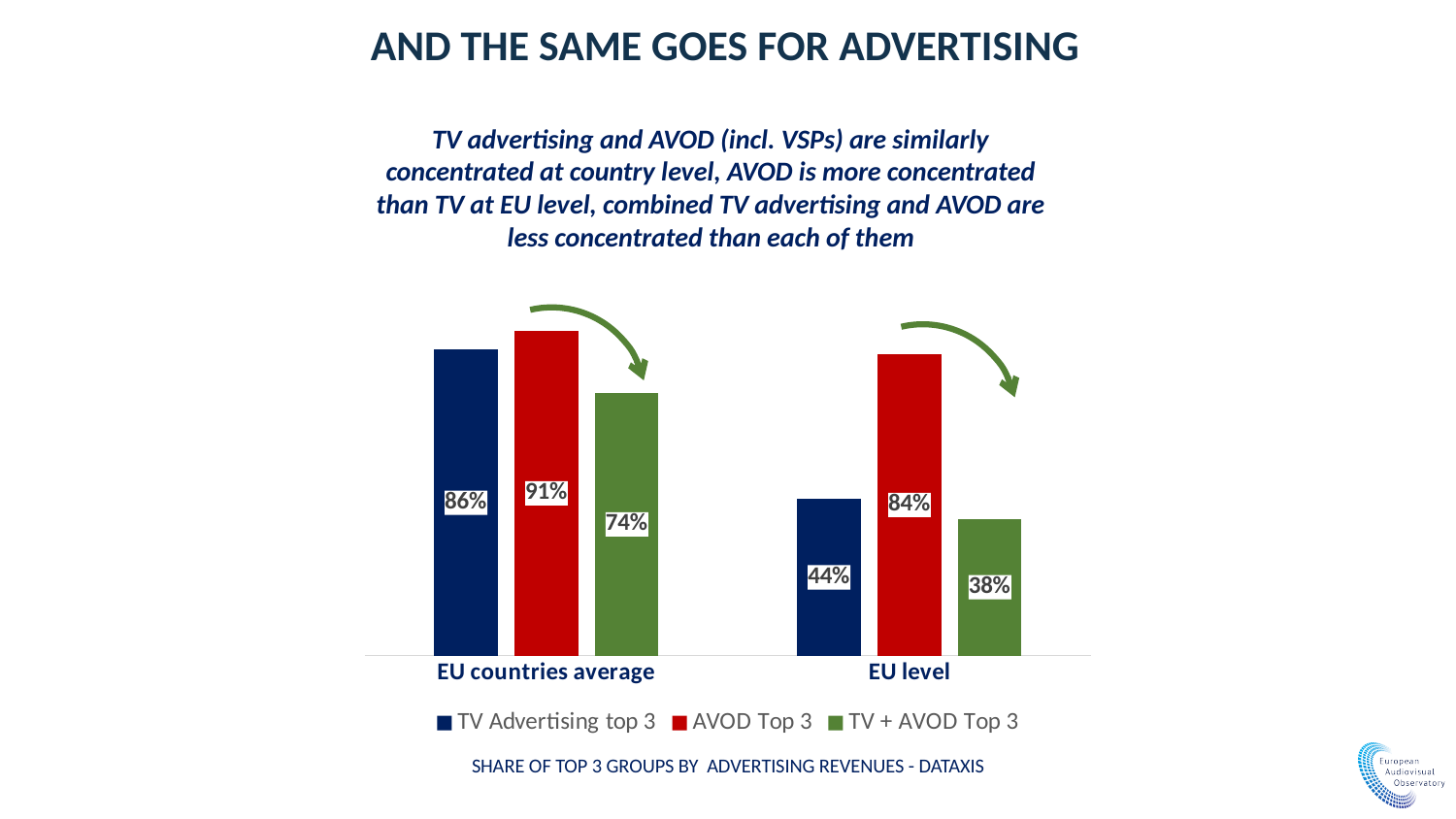
Which is larger: TV Advertising top 3 for EU countries average or AVOD Top 3 at EU level? TV Advertising top 3 for EU countries average What kind of chart is shown on the slide? Bar chart What is the value for TV + AVOD Top 3 in the EU countries average category? 74% How many series does the legend list? 3 What is the value for TV Advertising top 3 at EU level? 44% What is the difference between the AVOD Top 3 value and the TV Advertising top 3 value at EU level? 40% How many categories are shown on the x axis? 2 What is the value for AVOD Top 3 at EU level? 84% Which series has the lowest value at EU level? TV + AVOD Top 3 Which series has the highest value in the EU countries average category? AVOD Top 3 What is the difference between the TV + AVOD Top 3 value for EU countries average and for EU level? 36% What is the value for TV Advertising top 3 in the EU countries average category? 86%